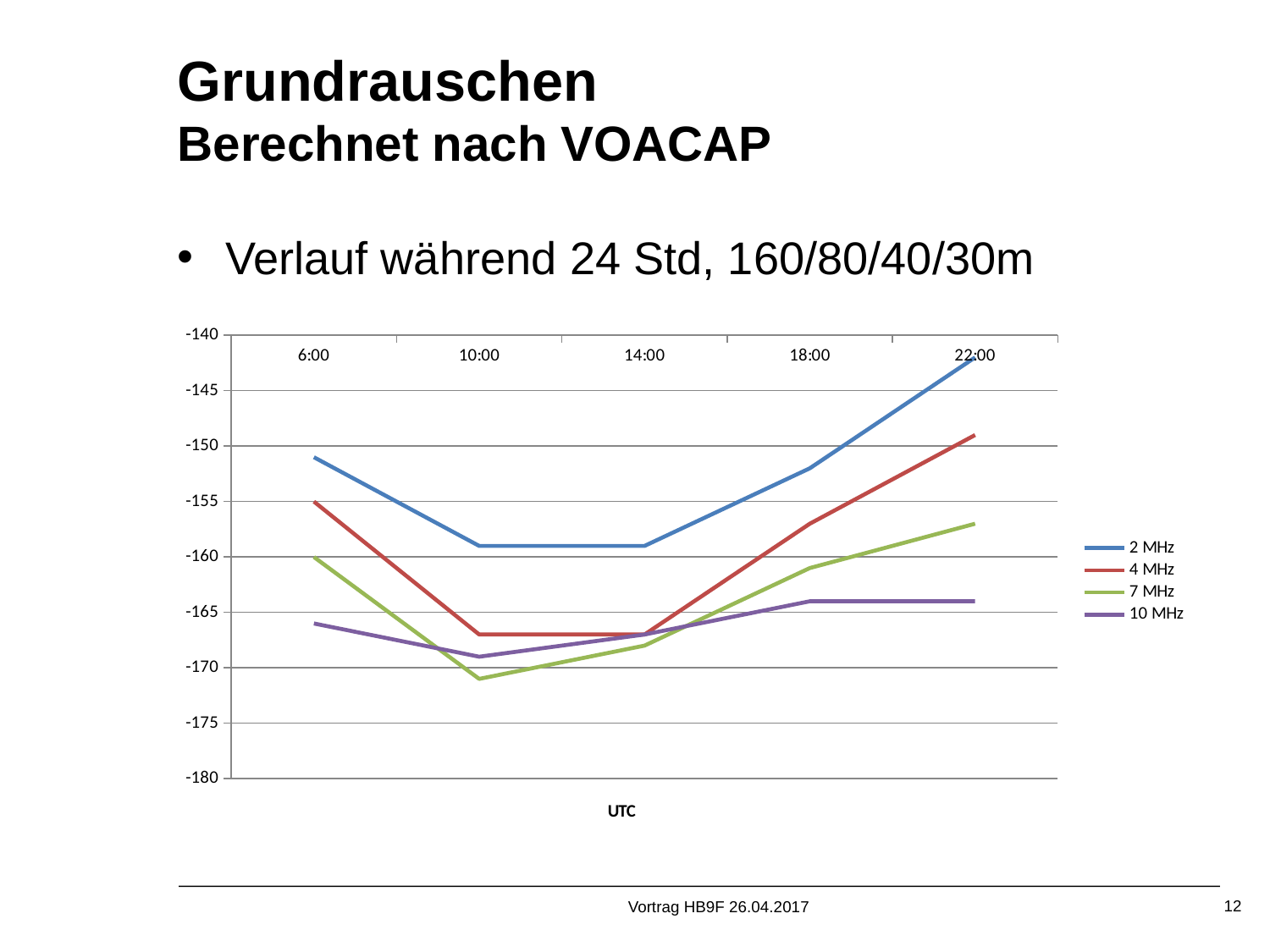
Which series has the lowest value at 10:00? 7 MHz Is the value for 2 MHz at 10:00 greater or less than -155? less How many time points are labelled on the x axis? 5 At 22:00, which is higher: 7 MHz or 10 MHz? 7 MHz What is the title of the x axis? UTC Does the 2 MHz series rise or fall from 14:00 to 22:00? rise How many series does the legend list? 4 At 6:00, which is higher: 4 MHz or 7 MHz? 4 MHz Which series has the highest value at 22:00? 2 MHz Is the value for 2 MHz at 18:00 greater or less than -155? greater What kind of chart is shown on the slide? line chart Is the value for 10 MHz at 18:00 greater or less than -160? less